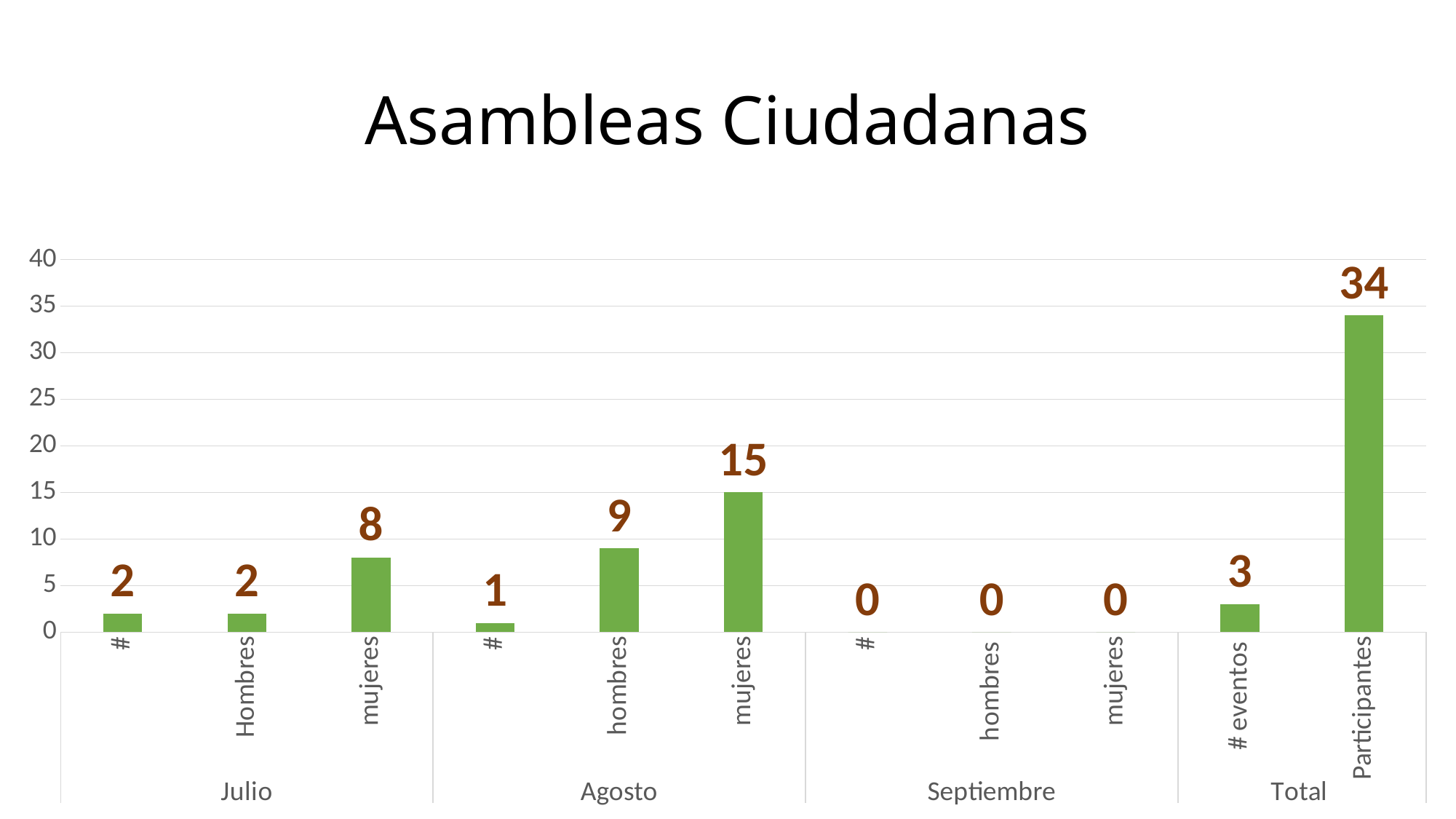
How many bars (categories) are plotted on the chart? 11 What is the value for Participantes under Total? 34 What is the value for mujeres in Agosto? 15 What is the value for hombres in Septiembre? 0 What is the title of the chart? Asambleas Ciudadanas What is the difference between Participantes and # eventos under Total? 31 What is the value for Hombres in Julio? 2 Which is larger, hombres in Agosto or mujeres in Julio? hombres in Agosto What is the difference between mujeres in Agosto and mujeres in Julio? 7 What is the value for # eventos under Total? 3 What kind of chart is shown? bar chart Which category has the highest value? Participantes (Total)